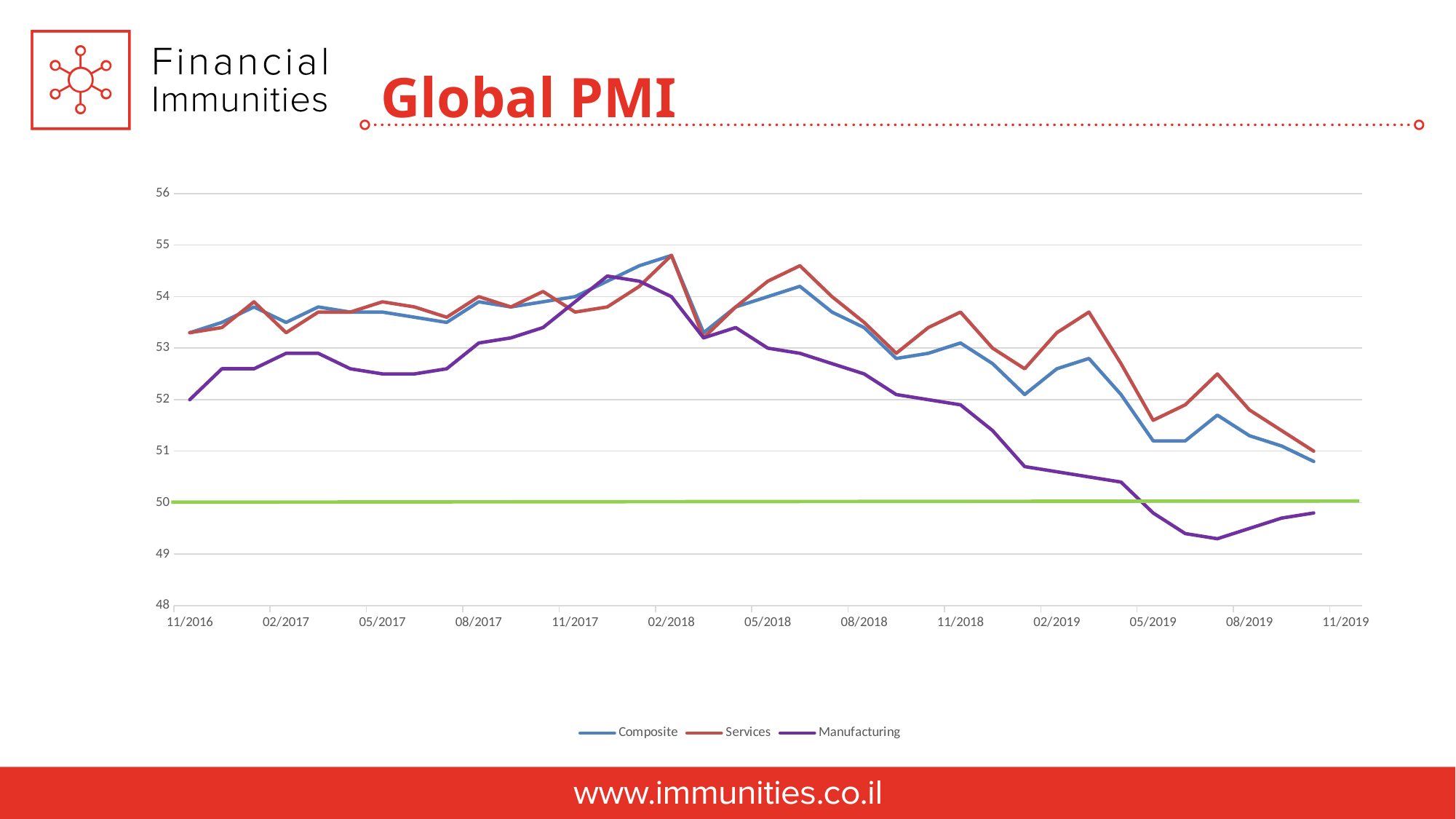
Is the value for Manufacturing at 08/2019 greater or less than 50? less Is the value for Composite at 05/2017 greater or less than 53? greater At 11/2016, which is higher, Composite or Manufacturing? Composite How many series does the legend list? 3 Which series is drawn in purple? Manufacturing Is the value for Services at 02/2018 greater or less than 54? greater At 08/2019, which is higher, Services or Manufacturing? Services What kind of chart is shown on the slide? line chart What is the title of the chart? Global PMI Which series has the lowest value at the right end of the chart? Manufacturing Does the Manufacturing line rise or fall between 02/2018 and 08/2019? fall